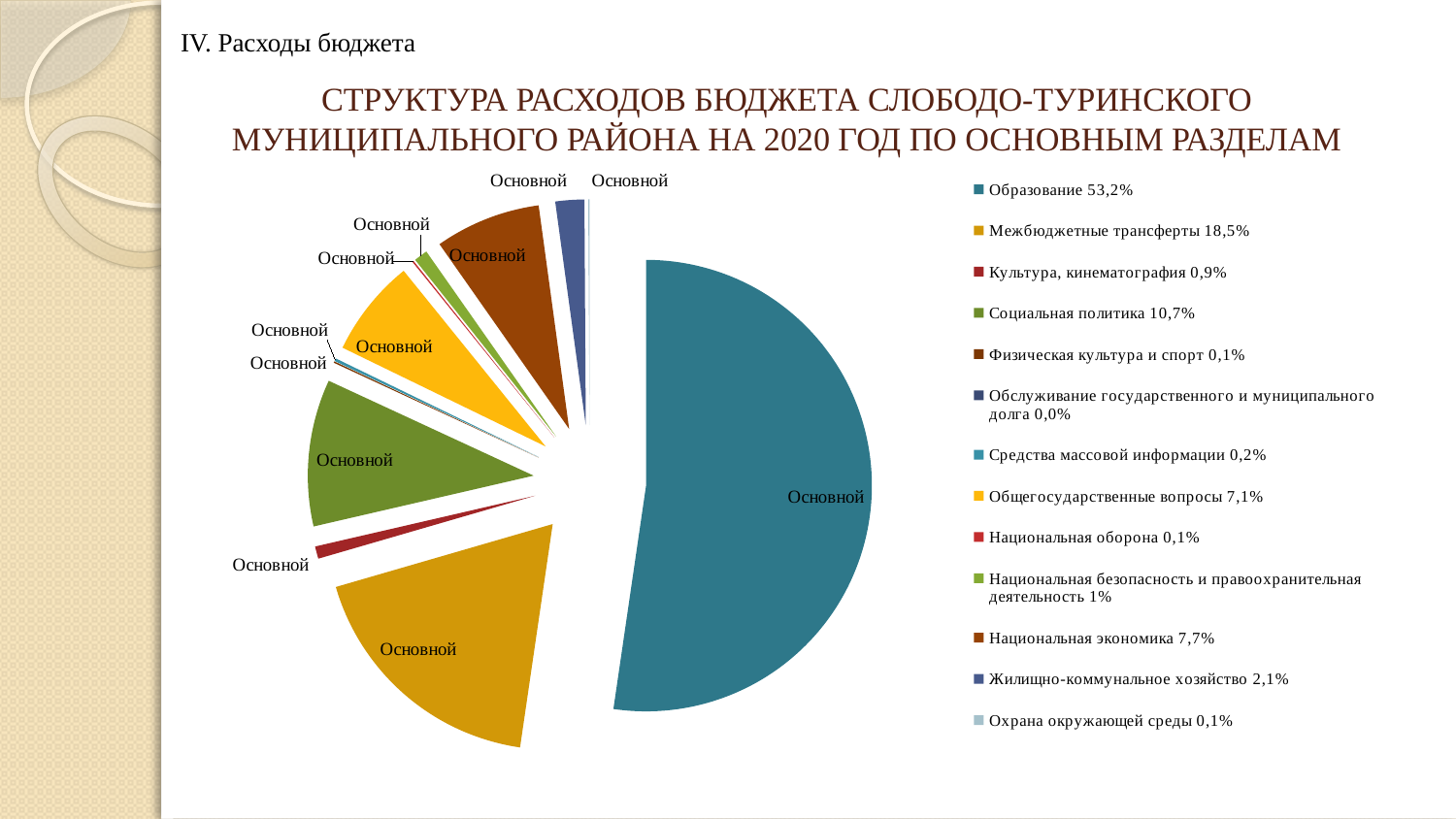
Which category has the largest share of the pie? Образование What percentage is shown for Жилищно-коммунальное хозяйство? 2,1% What is the difference in percentage points between Образование and Межбюджетные трансферты? 34,7 What is the title of the chart? СТРУКТУРА РАСХОДОВ БЮДЖЕТА СЛОБОДО-ТУРИНСКОГО МУНИЦИПАЛЬНОГО РАЙОНА НА 2020 ГОД ПО ОСНОВНЫМ РАЗДЕЛАМ What kind of chart is shown on the slide? pie chart How many categories does the legend of the pie chart list? 13 What percentage is shown for Национальная экономика? 7,7% Which category has the smallest share according to the legend? Обслуживание государственного и муниципального долга What percentage is shown for Межбюджетные трансферты? 18,5% What share of the budget expenditure does Образование account for? 53,2% What percentage is shown for Социальная политика? 10,7% Which is larger: Общегосударственные вопросы or Национальная экономика? Национальная экономика